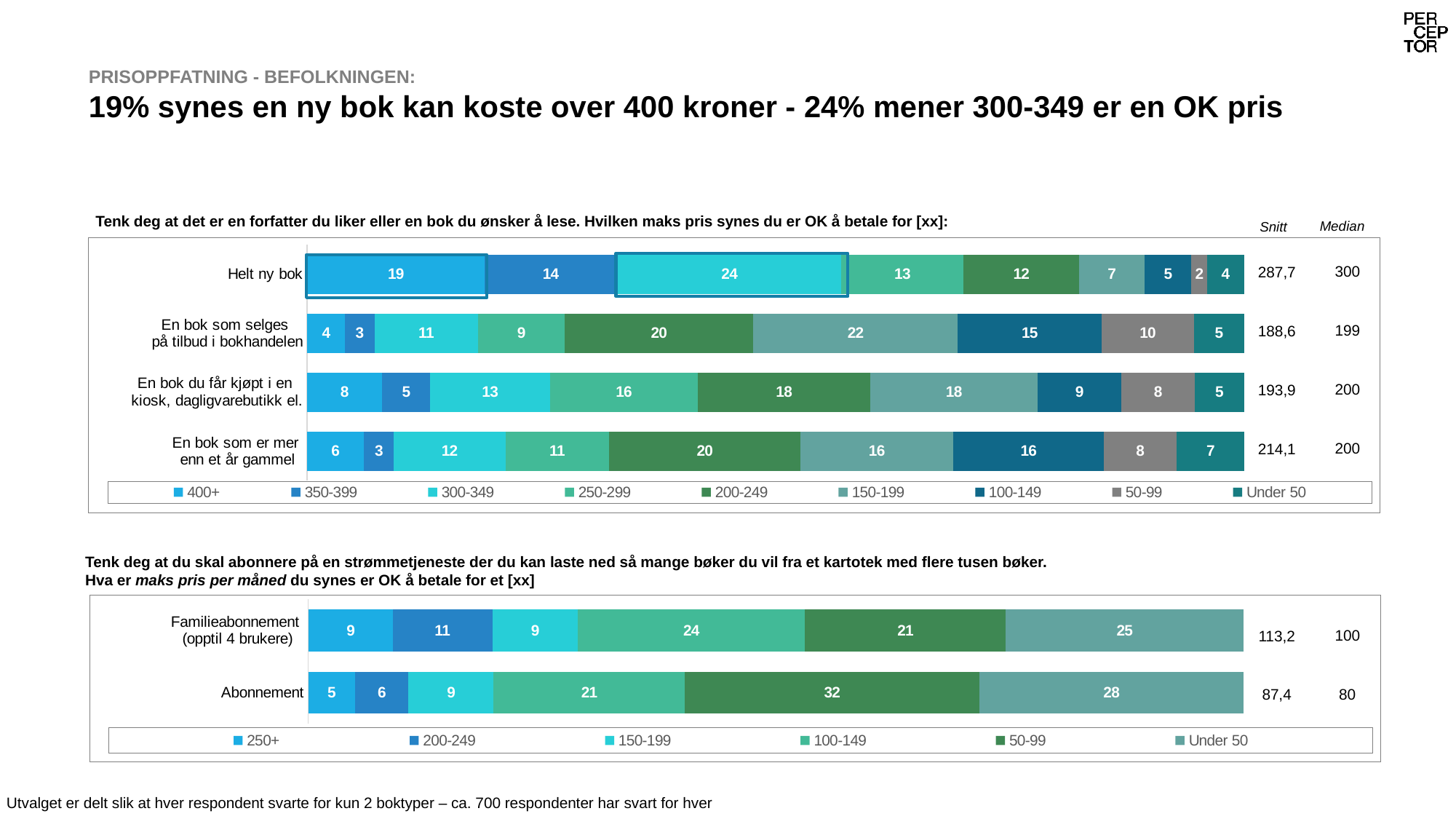
In the top chart, what is the Snitt (average) shown for 'Helt ny bok'? 287,7 In the top chart (maks pris for a book), what is the value of the 300-349 segment for 'Helt ny bok'? 24 What kind of chart is the bottom chart? Stacked bar chart In the top chart, how many categories (book types) are shown? 4 In the top chart, which category has the highest value for the 400+ segment? Helt ny bok In the top chart, what is the value of the 150-199 segment for 'En bok som selges på tilbud i bokhandelen'? 22 In the top chart, what is the difference between the 200-249 values for 'En bok som er mer enn et år gammel' and 'Helt ny bok'? 8 In the bottom chart, how many series does the legend list? 6 In the bottom chart (maks pris per måned), what is the value of the 50-99 segment for 'Abonnement'? 32 In the bottom chart, which is larger: the 100-149 value for 'Familieabonnement (opptil 4 brukere)' or for 'Abonnement'? Familieabonnement (opptil 4 brukere) In the top chart, how many series does the legend list? 9 In the top chart, which category has the lowest value for the 400+ segment? En bok som selges på tilbud i bokhandelen